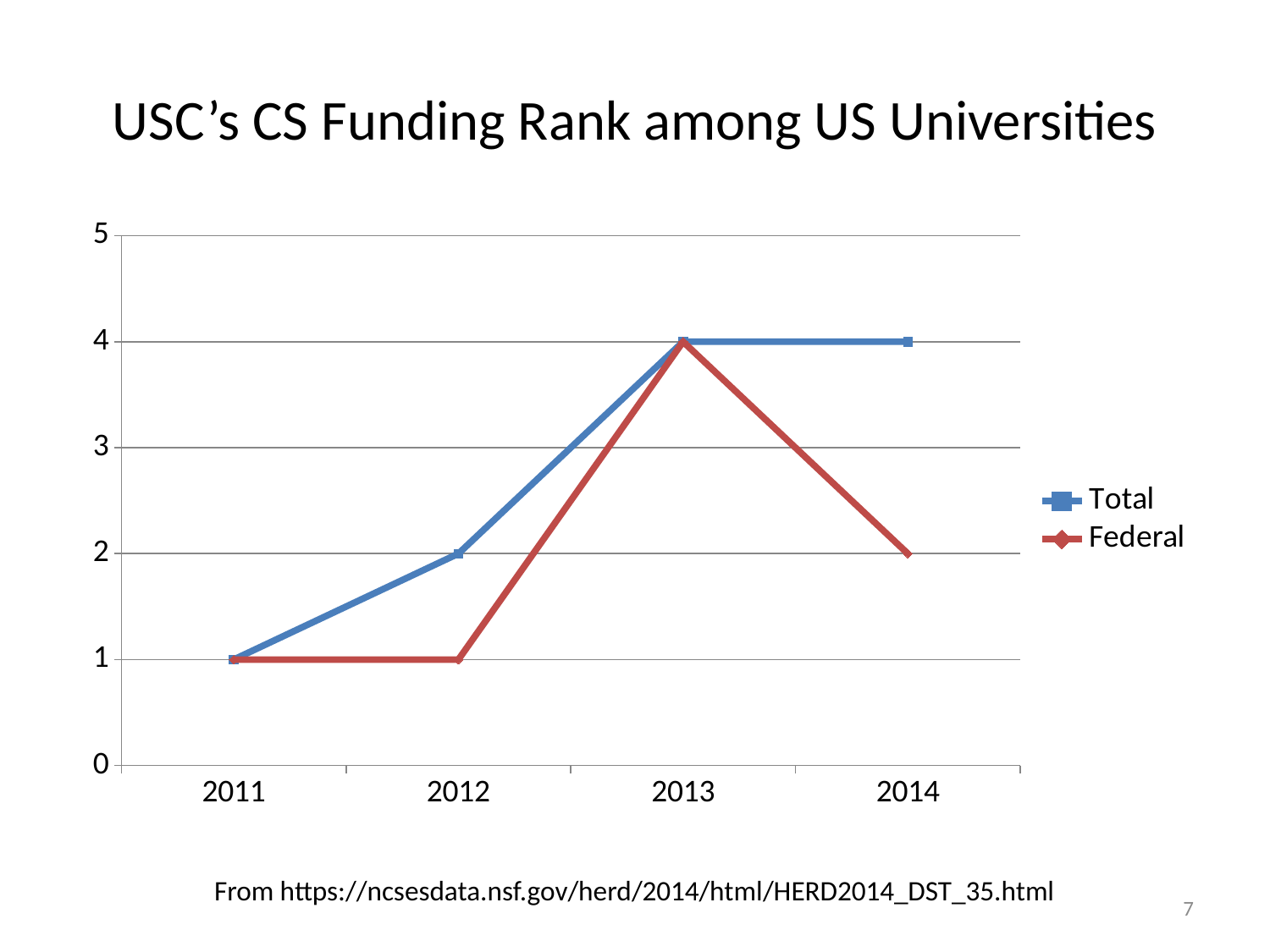
What is the difference between the Total and Federal values in 2014? 2 What is the Federal rank in 2014? 2 Does the Total series rise or fall from 2011 to 2013? Rise In which year does the Federal series reach its highest value? 2013 What is the Total rank in 2012? 2 What type of chart is shown on the slide? Line chart What is the Federal rank in 2012? 1 How many years are plotted on the x axis? 4 In 2012, which series has the larger value, Total or Federal? Total How many series does the legend list? 2 What is the title of the chart? USC's CS Funding Rank among US Universities What is the Total rank in 2014? 4